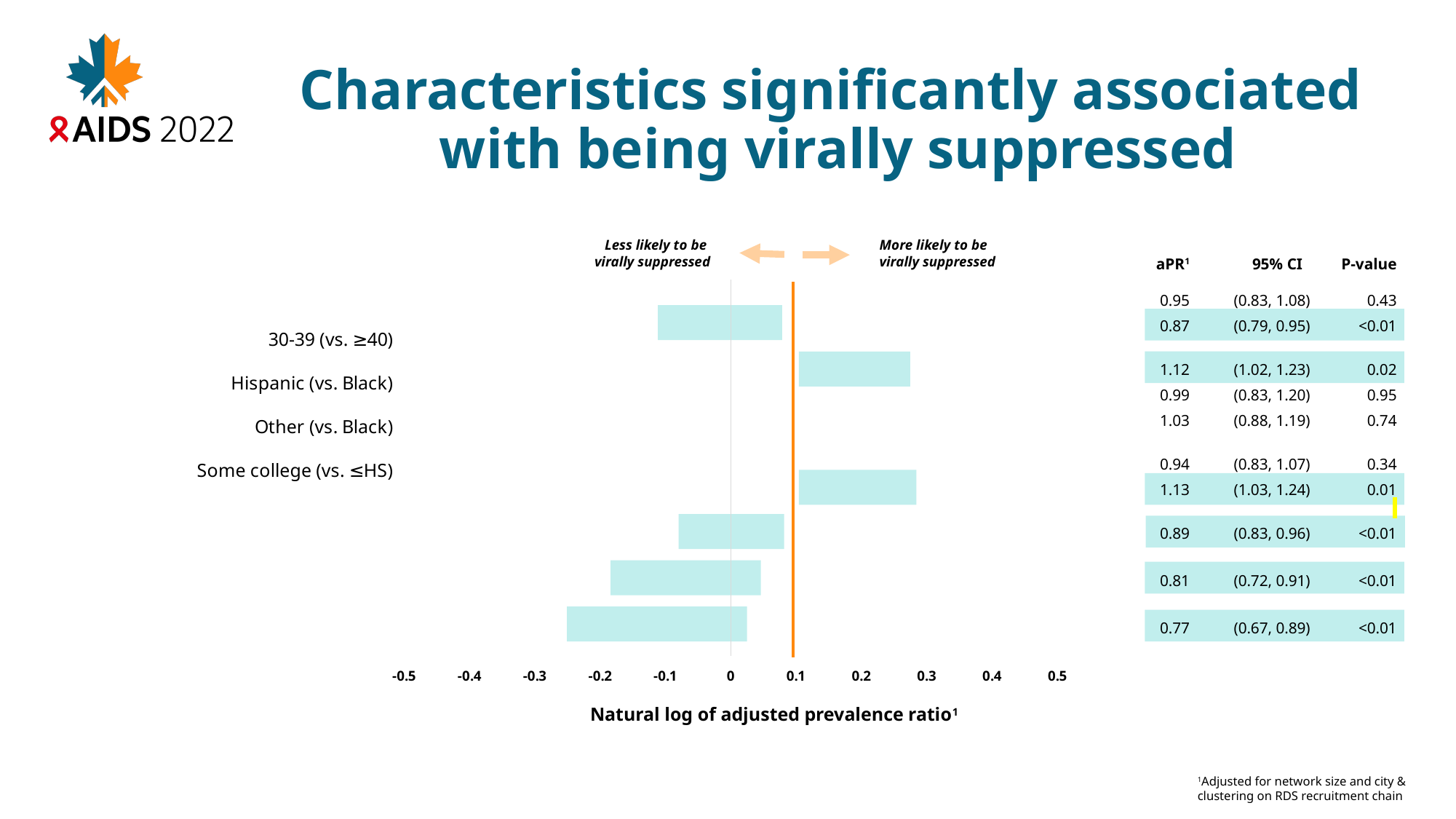
How many bars cross the zero line on the x axis? 4 What kind of chart is shown on the slide? bar chart What is the lowest aPR value listed in the table beside the chart? 0.77 What is the title of the slide's chart? Characteristics significantly associated with being virally suppressed What is the highest aPR value listed in the table beside the chart? 1.13 Is the left end of the bottom-most bar greater or less than -0.2 on the x axis? less What is the difference between the highest and lowest aPR values listed in the table? 0.36 Is the right end of the longest bar on the positive side of the axis greater or less than 0.2? greater How many bars lie entirely to the right of the orange vertical line? 2 How many bars are plotted in the chart? 6 What is the title of the x axis of the chart? Natural log of adjusted prevalence ratio